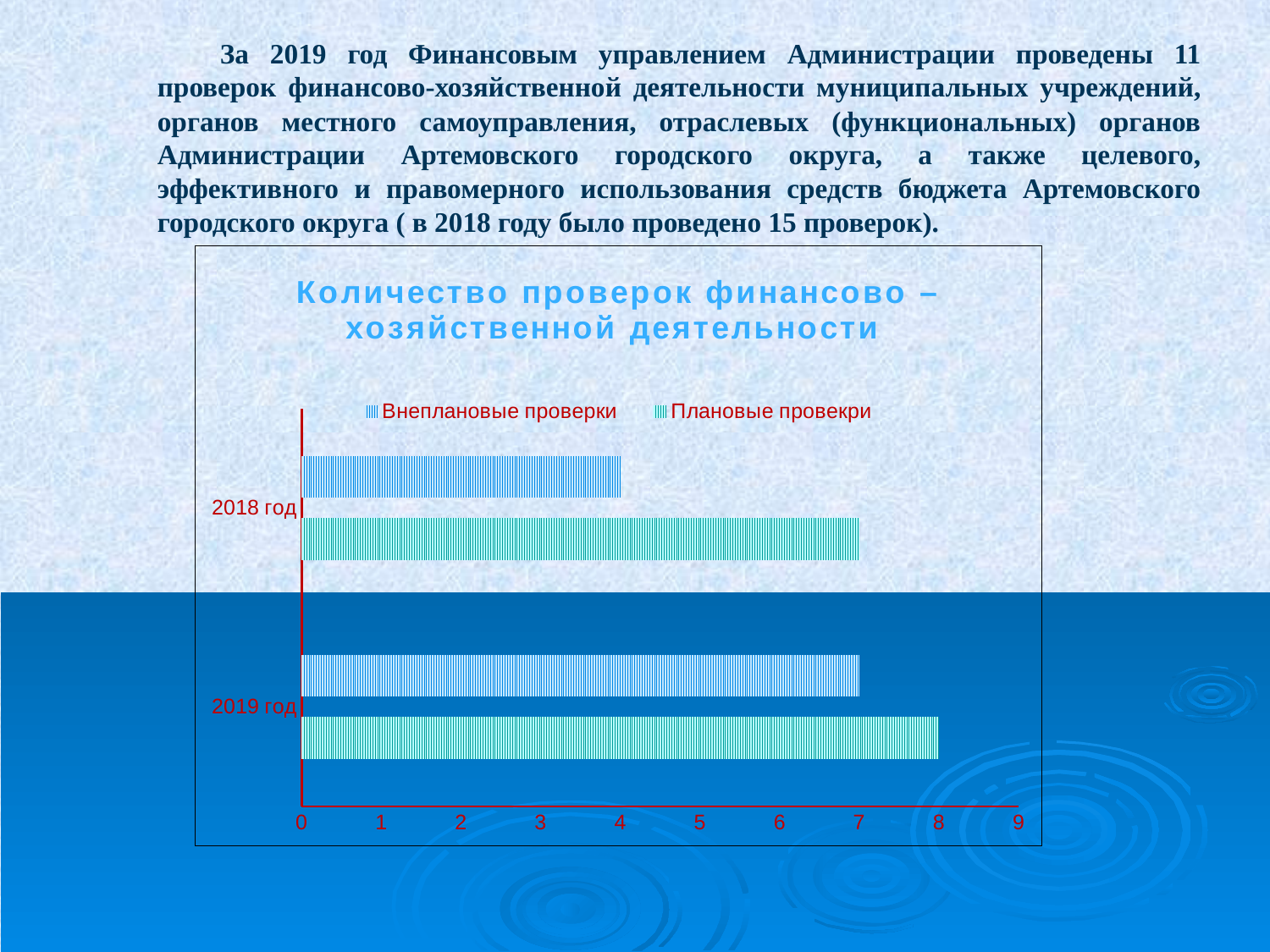
What kind of chart is shown on the slide? bar chart Which bar on the chart is the longest? Плановые провекри, 2019 год What is the title of the chart? Количество проверок финансово – хозяйственной деятельности What is the value of Внеплановые проверки for 2018 год? 4 Is the value of Плановые провекри for 2018 год greater or less than 5? greater Which bar on the chart is the shortest? Внеплановые проверки, 2018 год How many categories (years) are shown on the chart? 2 Is the value of Внеплановые проверки for 2018 год greater or less than 5? less For 2018 год, which is larger: Внеплановые проверки or Плановые провекри? Плановые провекри What is the difference between Плановые провекри and Внеплановые проверки for 2018 год? 3 How many series does the chart legend list? 2 What is the value of Плановые провекри for 2019 год? 8